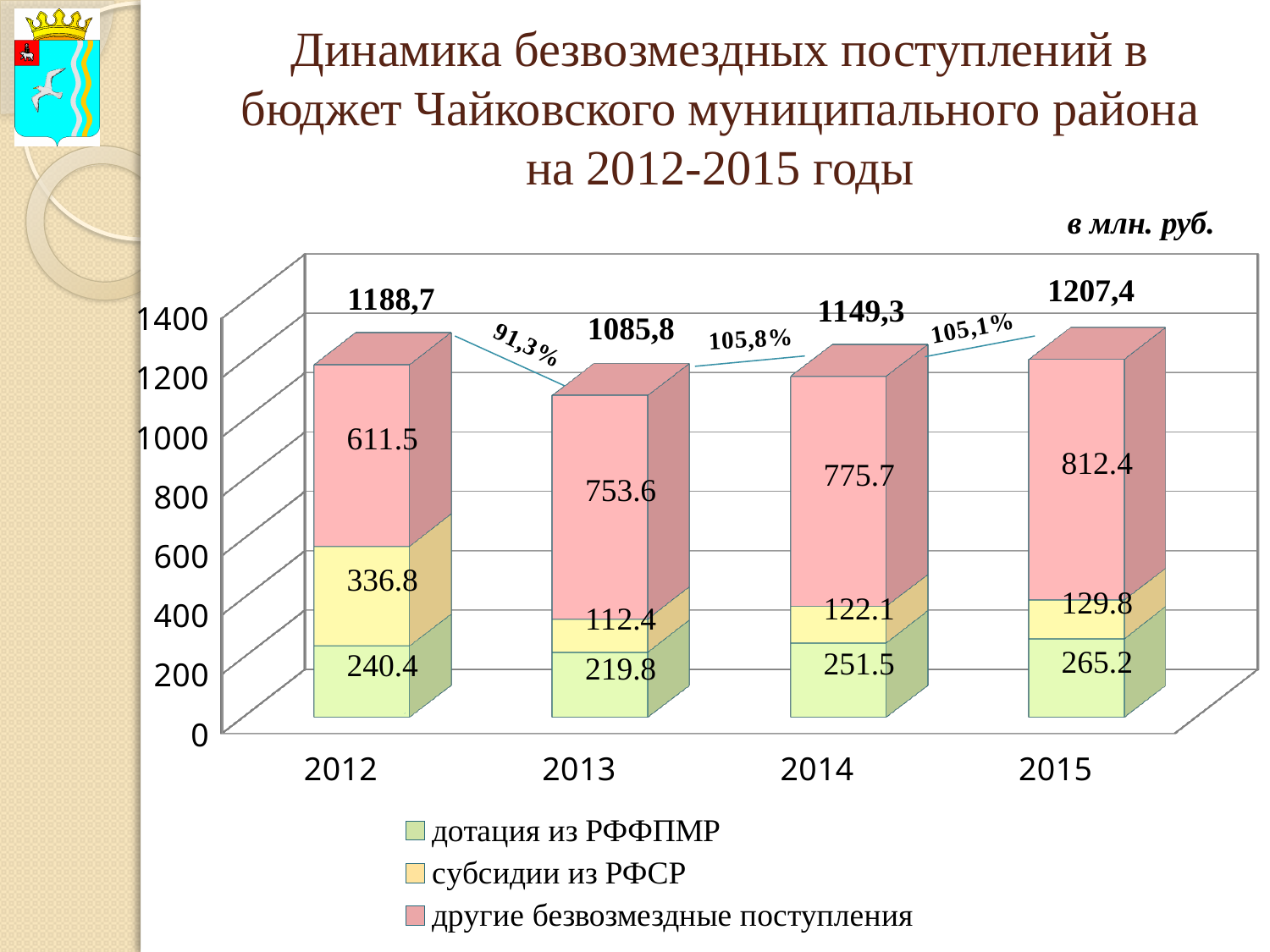
How many years (categories) are shown on the x axis? 4 What percentage change is shown between the 2012 and 2013 totals? 91,3% What is the value of 'субсидии из РФСР' in 2014? 122.1 How many series does the legend list? 3 Which year has the lowest value for 'дотация из РФФПМР'? 2013 What is the value of 'дотация из РФФПМР' in 2012? 240.4 Which is larger: 'субсидии из РФСР' in 2012 or in 2015? 2012 What is the total labelled above the bar for 2013? 1085,8 Which year has the highest total of безвозмездные поступления? 2015 What type of chart is shown on the slide? stacked bar chart What is the value of 'другие безвозмездные поступления' in 2015? 812.4 What is the difference between 'другие безвозмездные поступления' in 2014 and in 2013? 22.1